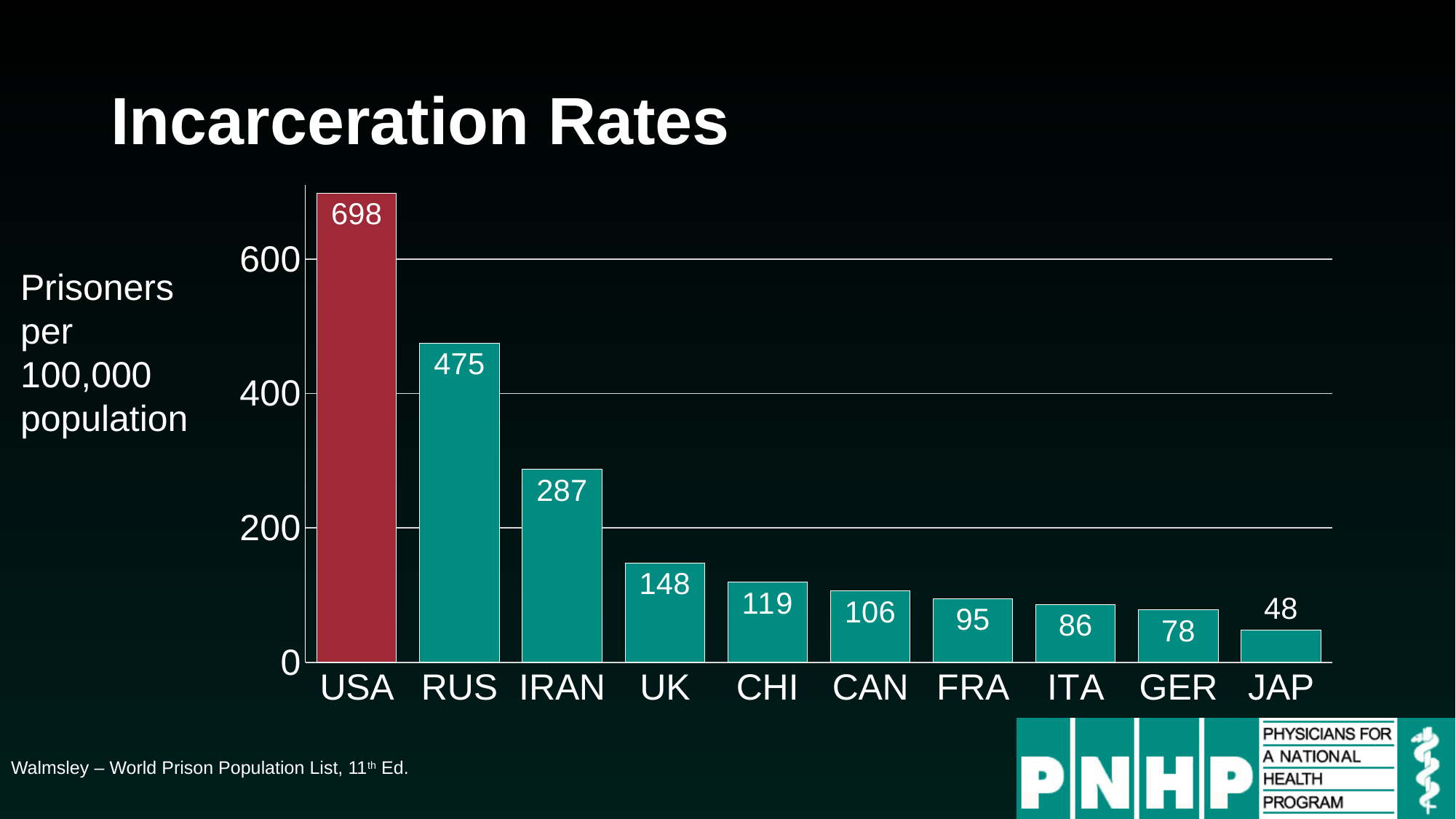
What is the incarceration rate for the USA? 698 What is the value shown for JAP? 48 Which country has the lowest incarceration rate? JAP Which has a higher value, IRAN or UK? IRAN What is the value shown for RUS? 475 Which country has the highest incarceration rate? USA What is the difference between the values for USA and RUS? 223 Which bar is coloured differently (red) from the others? USA What kind of chart is shown on the slide? Bar chart What is the value shown for CAN? 106 How many countries are shown in the chart? 10 What is the difference between the values for UK and GER? 70